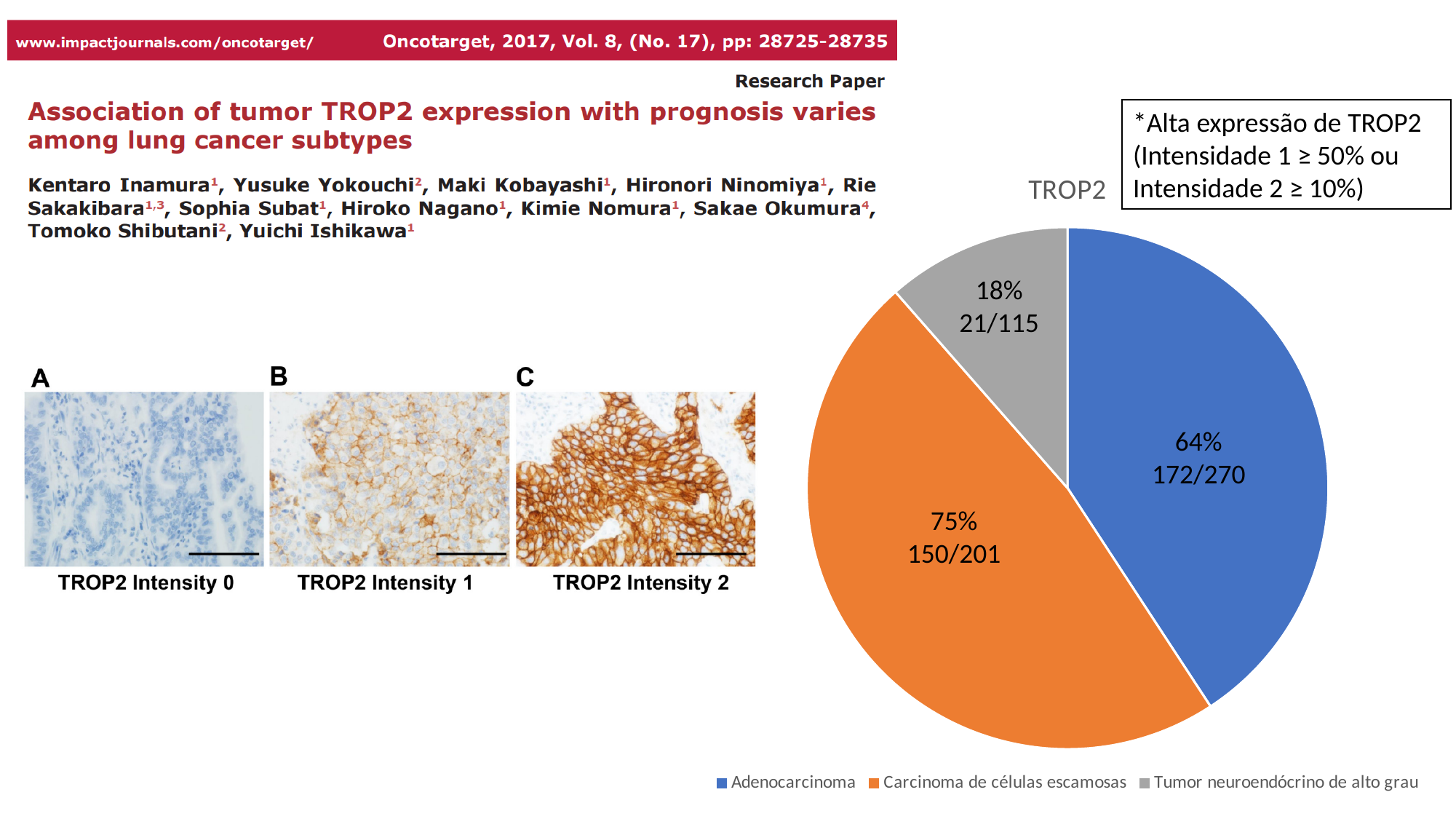
What percentage is shown for Tumor neuroendócrino de alto grau in the TROP2 pie chart? 18% Which category in the TROP2 pie chart has the highest percentage label? Carcinoma de células escamosas What is the difference in percentage points between the Carcinoma de células escamosas label and the Adenocarcinoma label in the TROP2 pie chart? 11 What kind of chart is shown on the right side of the slide? Pie chart In the TROP2 pie chart, which has the larger percentage label: Adenocarcinoma or Tumor neuroendócrino de alto grau? Adenocarcinoma What fraction is printed on the Adenocarcinoma slice of the TROP2 pie chart? 172/270 Which category in the TROP2 pie chart has the lowest percentage label? Tumor neuroendócrino de alto grau How many categories does the TROP2 pie chart show? 3 What percentage is shown for Adenocarcinoma in the TROP2 pie chart? 64% How many entries does the legend of the TROP2 pie chart list? 3 Which colour represents Adenocarcinoma in the TROP2 pie chart? Blue What fraction is printed on the Carcinoma de células escamosas slice of the TROP2 pie chart? 150/201